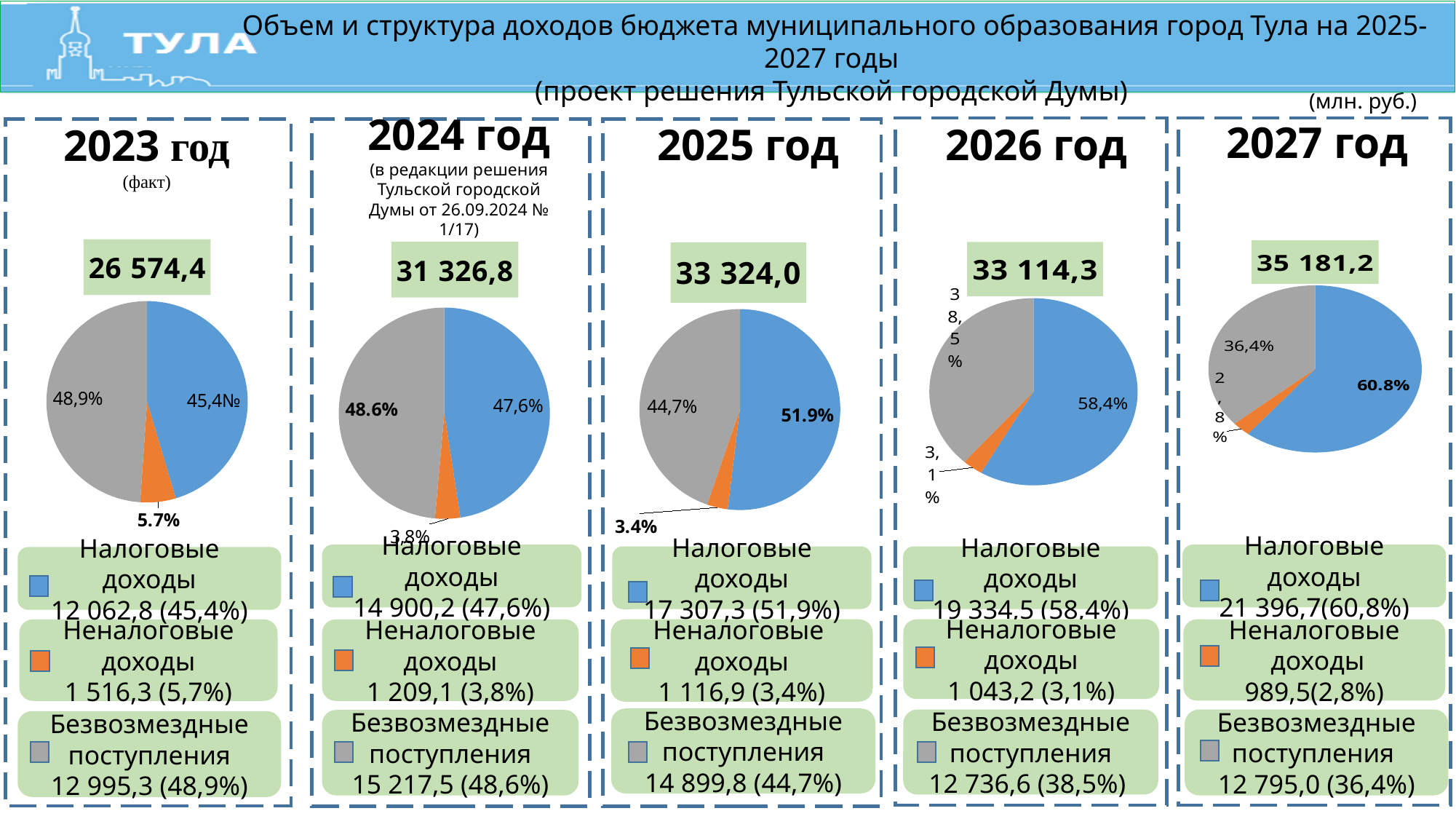
In the 2026 год chart, what share of the pie is Безвозмездные поступления? 38,5% Across the charts from 2023 год to 2027 год, does the share of Налоговые доходы rise or fall? rise In the 2026 год chart, which category has the smallest slice? Неналоговые доходы In the 2025 год chart, what share of revenue is Налоговые доходы? 51,9% What colour represents Неналоговые доходы in the pie charts? orange In the 2023 год chart, which category has the largest slice? Безвозмездные поступления In the 2024 год chart, which is larger: Налоговые доходы or Безвозмездные поступления? Безвозмездные поступления What is the total revenue shown above the 2024 год chart? 31 326,8 What kind of chart is used for the 2025 год panel? pie chart In the 2025 год chart, what is the difference between Налоговые доходы and Безвозмездные поступления in млн. руб.? 2 407,5 How many slices does each pie chart on the slide have? 3 In the 2027 год chart, what is the value of Неналоговые доходы? 989,5